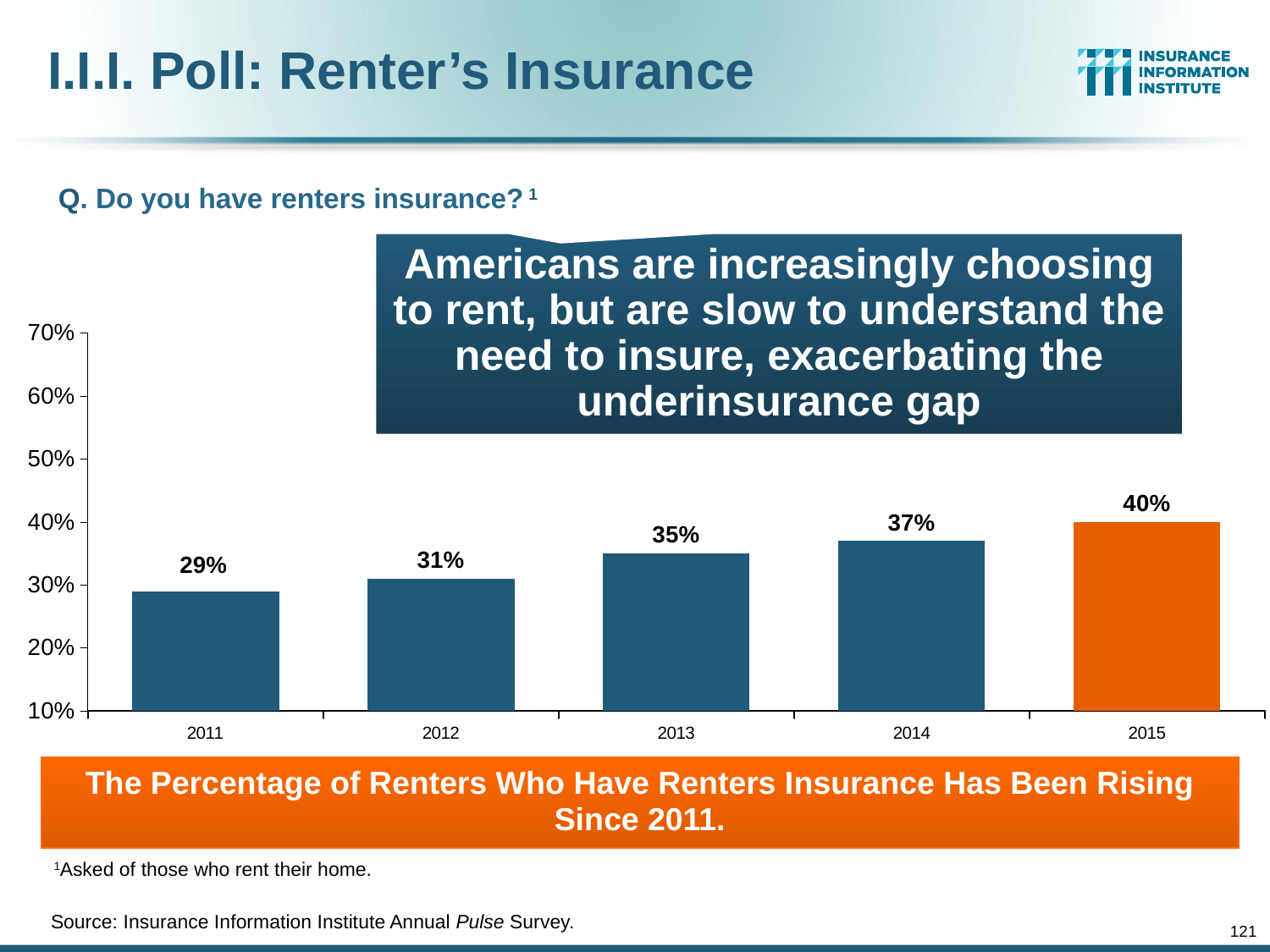
What is the difference between the 2015 value and the 2011 value? 11 percentage points Which year has the lowest percentage of renters with renters insurance? 2011 How many years are shown on the x axis of the chart? 5 Do the values rise or fall from 2011 to 2015? Rise What percentage of renters had renters insurance in 2011? 29% What kind of chart is shown on the slide? Bar chart What is the difference between the 2014 and 2012 values? 6 percentage points Is the value for 2013 greater or less than 30%? greater Which year has the highest percentage of renters with renters insurance? 2015 Which is larger, the value for 2012 or the value for 2014? 2014 What percentage is shown for 2015? 40% What is the value shown for 2013? 35%